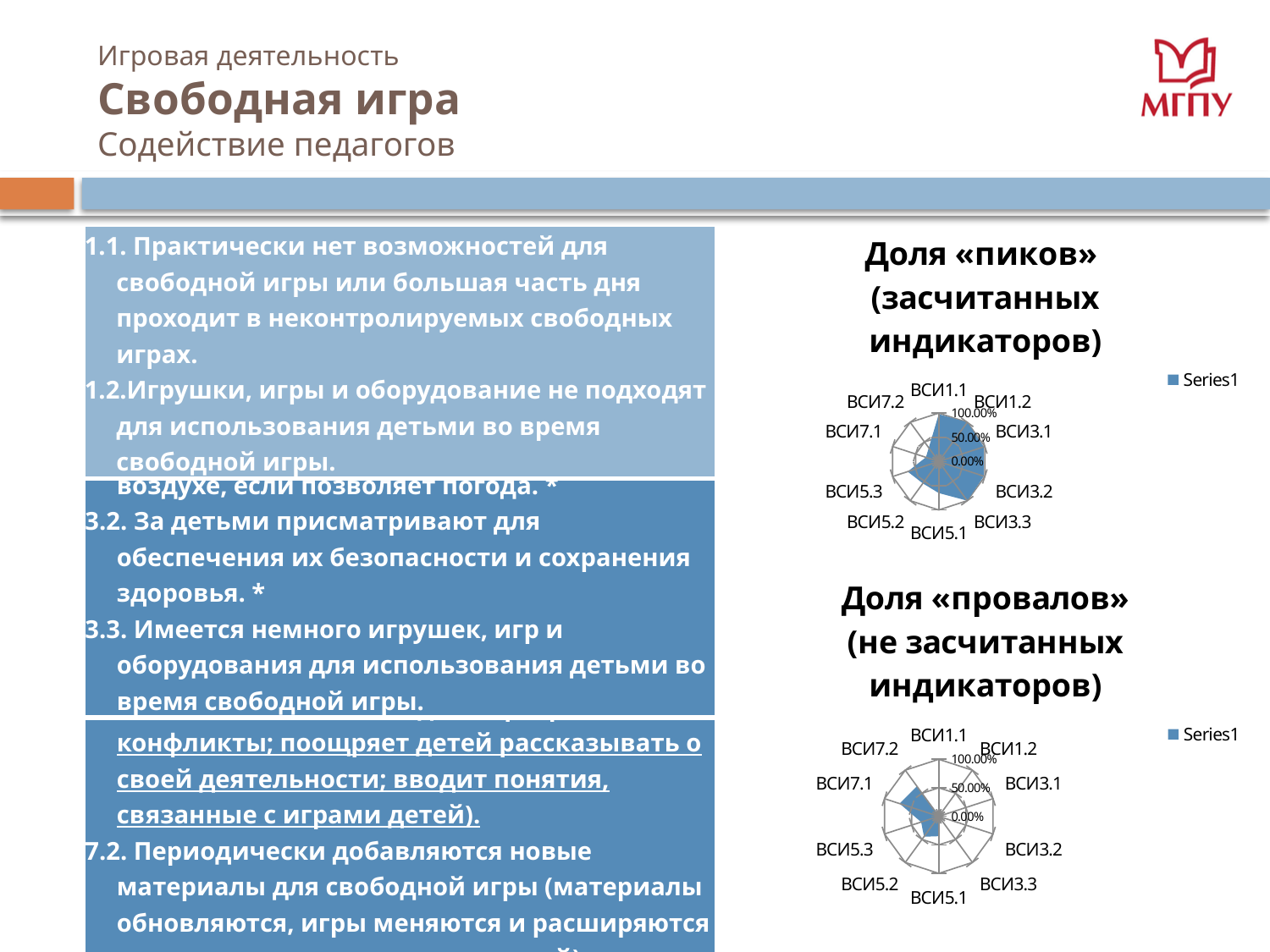
In the bottom chart «Доля «провалов»», is the value for ВСИ3.2 greater or less than 50.00%? less What kind of chart is the bottom chart titled «Доля «провалов» (не засчитанных индикаторов)»? radar chart How many series does the legend of the bottom chart «Доля «провалов»» list? 1 What is the legend entry shown for the top chart «Доля «пиков»»? Series1 In the top chart «Доля «пиков»», is the value for ВСИ7.2 greater or less than 50.00%? less In the bottom chart «Доля «провалов»», how many categories are plotted around the radar? 10 In the bottom chart «Доля «провалов»», is the value for ВСИ1.2 greater or less than 50.00%? less What is the highest axis tick label shown on the bottom chart «Доля «провалов»»? 100.00% In the top chart «Доля «пиков»», how many categories are plotted around the radar? 10 How many series does the legend of the top chart «Доля «пиков»» list? 1 What kind of chart is the top chart titled «Доля «пиков» (засчитанных индикаторов)»? radar chart